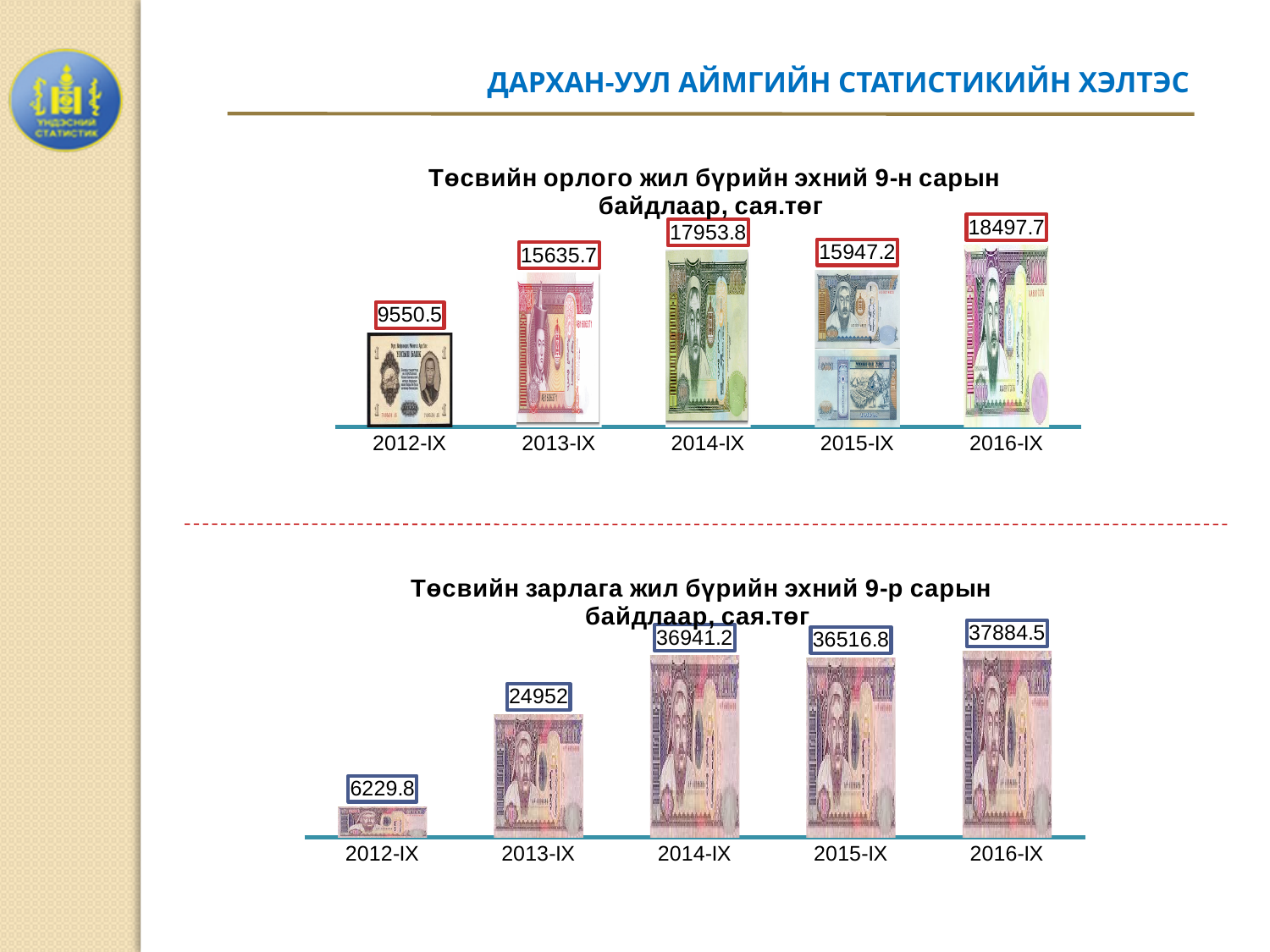
In the top chart (Төсвийн орлого), what is the value for 2015-IX? 15947.2 In the bottom chart (Төсвийн зарлага), which period has the lowest value? 2012-IX In the bottom chart (Төсвийн зарлага), what is the value for 2016-IX? 37884.5 How many periods are shown on the x axis of the bottom chart (Төсвийн зарлага)? 5 What kind of chart is the top chart (Төсвийн орлого)? bar chart In the top chart (Төсвийн орлого), what is the value for 2012-IX? 9550.5 In the top chart (Төсвийн орлого), which period has the lowest value? 2012-IX In the bottom chart (Төсвийн зарлага), what is the difference between the 2014-IX and 2013-IX values? 11989.2 In the bottom chart (Төсвийн зарлага), what is the value for 2013-IX? 24952 In the top chart (Төсвийн орлого), which period has the highest value? 2016-IX In the top chart (Төсвийн орлого), which is larger: the value for 2014-IX or 2015-IX? 2014-IX In the top chart (Төсвийн орлого), what is the difference between the 2016-IX and 2012-IX values? 8947.2